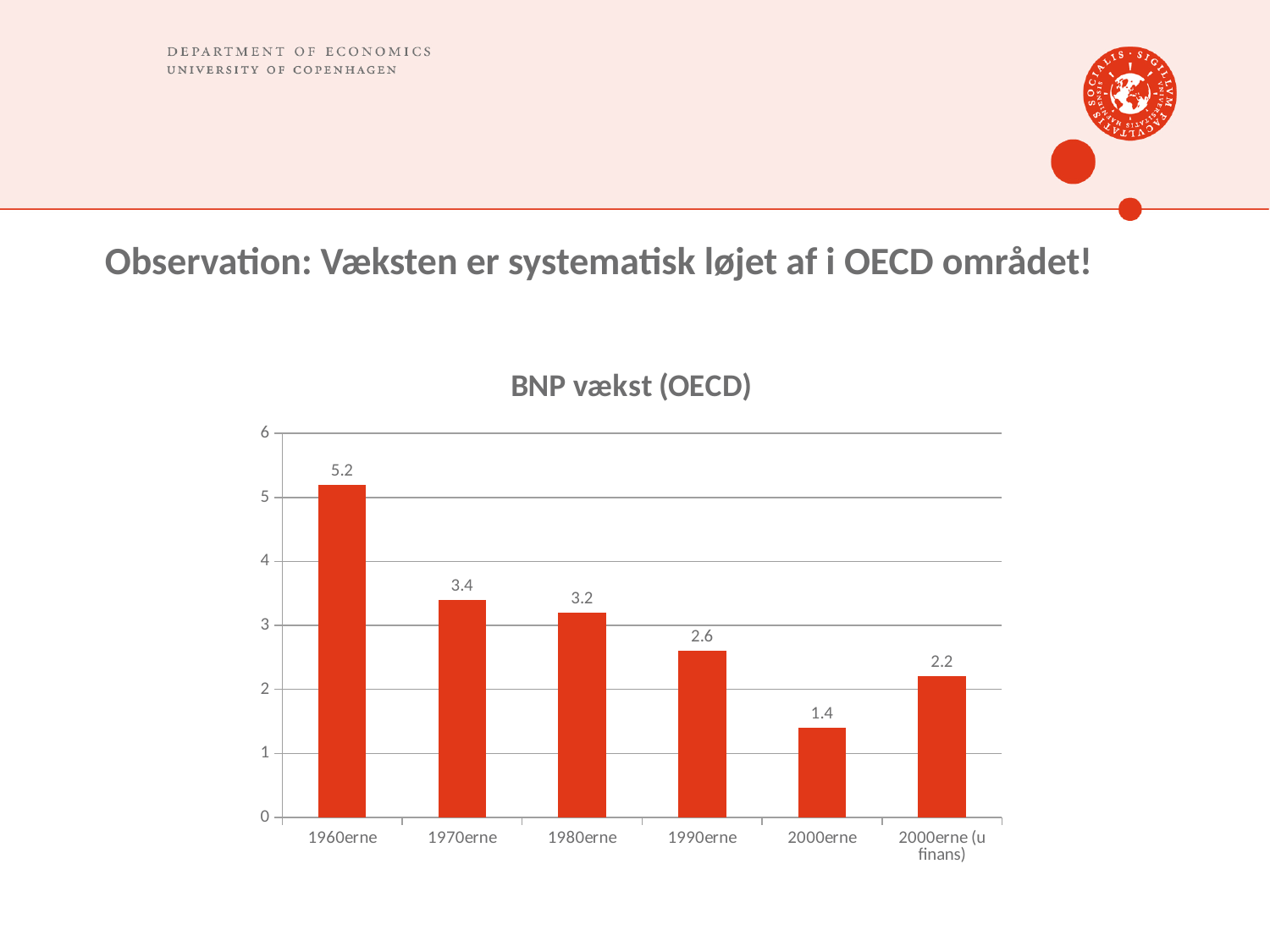
Which category has the highest value? 1960erne Is the value for 1970erne greater or less than 3? greater What is the value for 2000erne (u finans)? 2.2 Which category has the lowest value? 2000erne What is the value for 1990erne? 2.6 What is the difference between the values for 1970erne and 1980erne? 0.2 Which is larger, the value for 1990erne or the value for 2000erne (u finans)? 1990erne What is the title of the chart? BNP vækst (OECD) What is the value for 1960erne? 5.2 What kind of chart is this? bar chart How many categories are shown on the x axis? 6 What is the difference between the values for 1960erne and 2000erne? 3.8